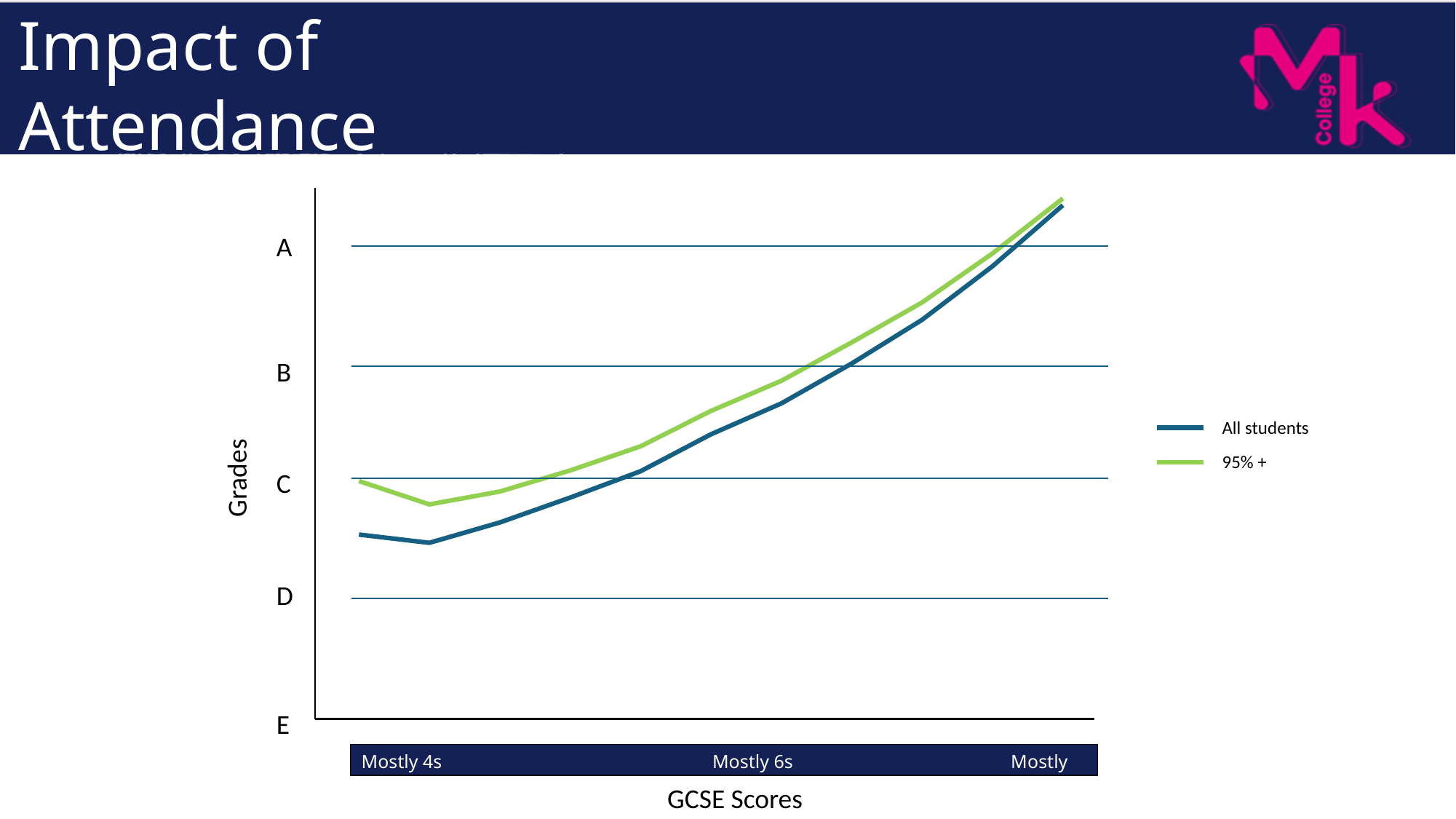
Do the grades for All students rise or fall as GCSE scores increase from Mostly 4s to Mostly 6s and beyond? Rise What kind of chart is shown on the slide? Line chart What is the title of the vertical axis? Grades What are the two series named in the legend? All students and 95% + Which series reaches the lowest grade on the chart? All students Is the grade for All students at Mostly 6s above or below the B gridline? Below Is the grade for All students at Mostly 4s above or below the C gridline? Below Which series is drawn in green? 95% + How many series does the legend list? 2 At Mostly 6s, which series has the higher grade: All students or 95% +? 95% + At Mostly 4s, which series has the higher grade: All students or 95% +? 95% + Is the grade for 95% + at Mostly 6s above or below the C gridline? Above